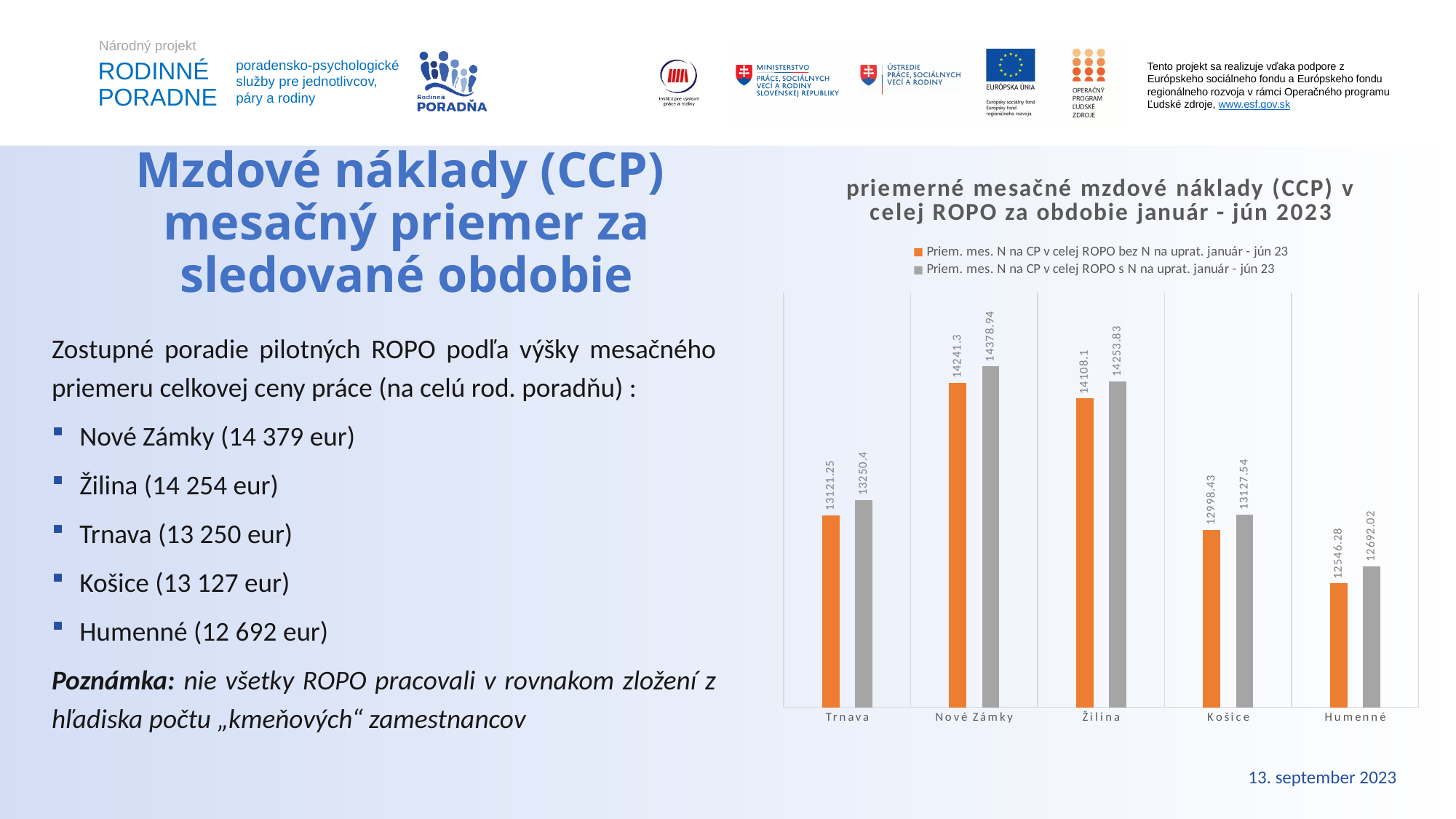
How many categories (ROPO locations) are shown on the x axis of the chart? 5 What type of chart is shown on the slide? bar chart Which category has the highest value in the series 'Priem. mes. N na CP v celej ROPO s N na uprat. január - jún 23'? Nové Zámky Which is larger: the 'bez N na uprat.' value for Trnava or the 'bez N na uprat.' value for Košice? Trnava What colour are the bars for the series 'Priem. mes. N na CP v celej ROPO bez N na uprat. január - jún 23'? orange What is the value for Trnava in the series 'Priem. mes. N na CP v celej ROPO bez N na uprat. január - jún 23'? 13121.25 Which category has the lowest value in the series 'Priem. mes. N na CP v celej ROPO bez N na uprat. január - jún 23'? Humenné How many series does the chart legend list? 2 What is the value for Košice in the series 'Priem. mes. N na CP v celej ROPO s N na uprat. január - jún 23'? 13127.54 What is the value for Nové Zámky in the series 'Priem. mes. N na CP v celej ROPO s N na uprat. január - jún 23'? 14378.94 What is the value for Humenné in the series 'Priem. mes. N na CP v celej ROPO bez N na uprat. január - jún 23'? 12546.28 What is the difference between the two series values for Žilina (14253.83 and 14108.1)? 145.73